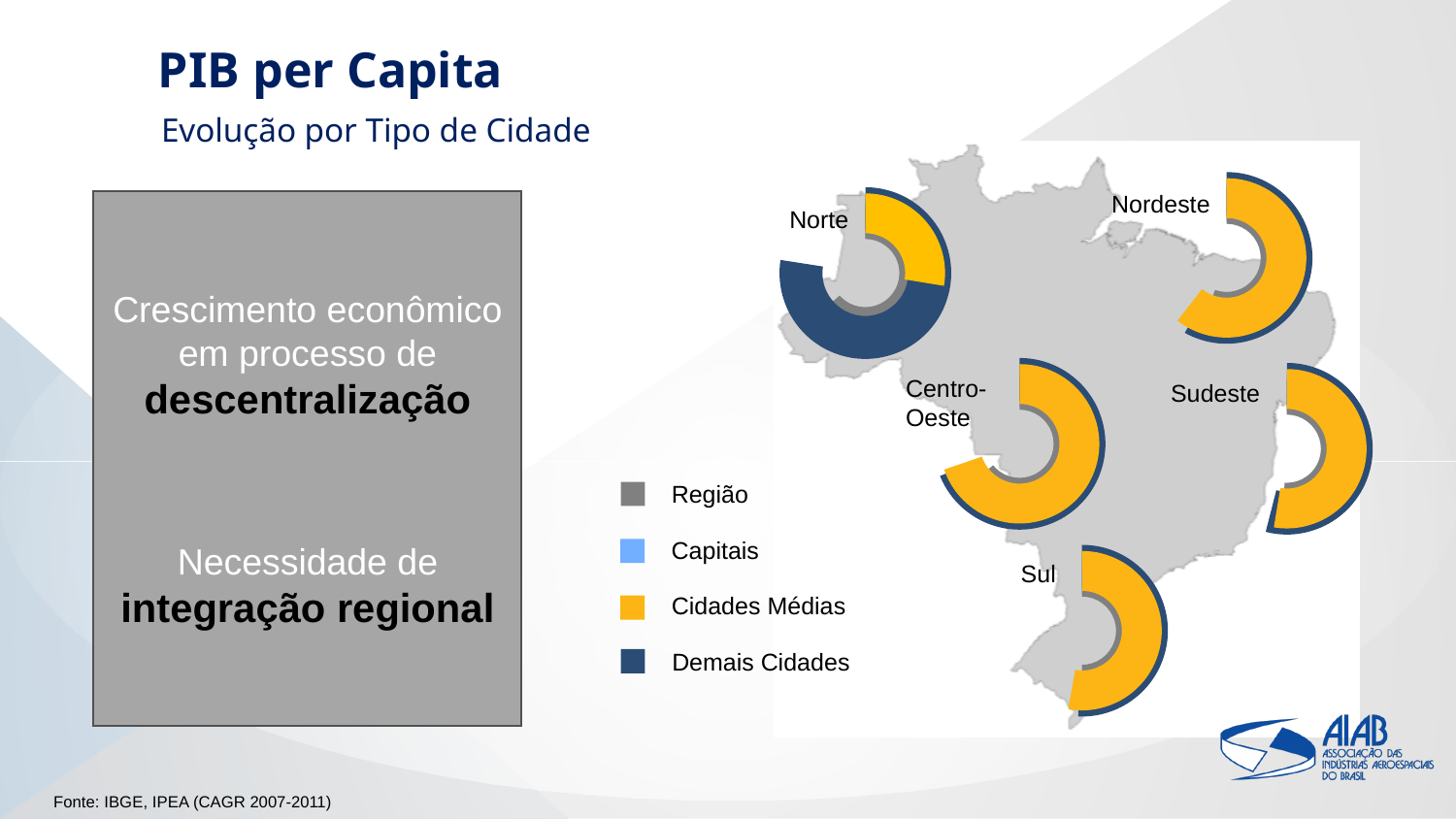
Which regions are labelled on the map with charts? Norte, Nordeste, Centro-Oeste, Sudeste, Sul What is the title of the slide containing the regional charts? PIB per Capita How many regions of Brazil have a chart placed on the map? 5 How many entries does the legend list? 4 Which legend entry is shown in orange? Cidades Médias Which region's chart shows the largest dark blue (Demais Cidades) arc? Norte